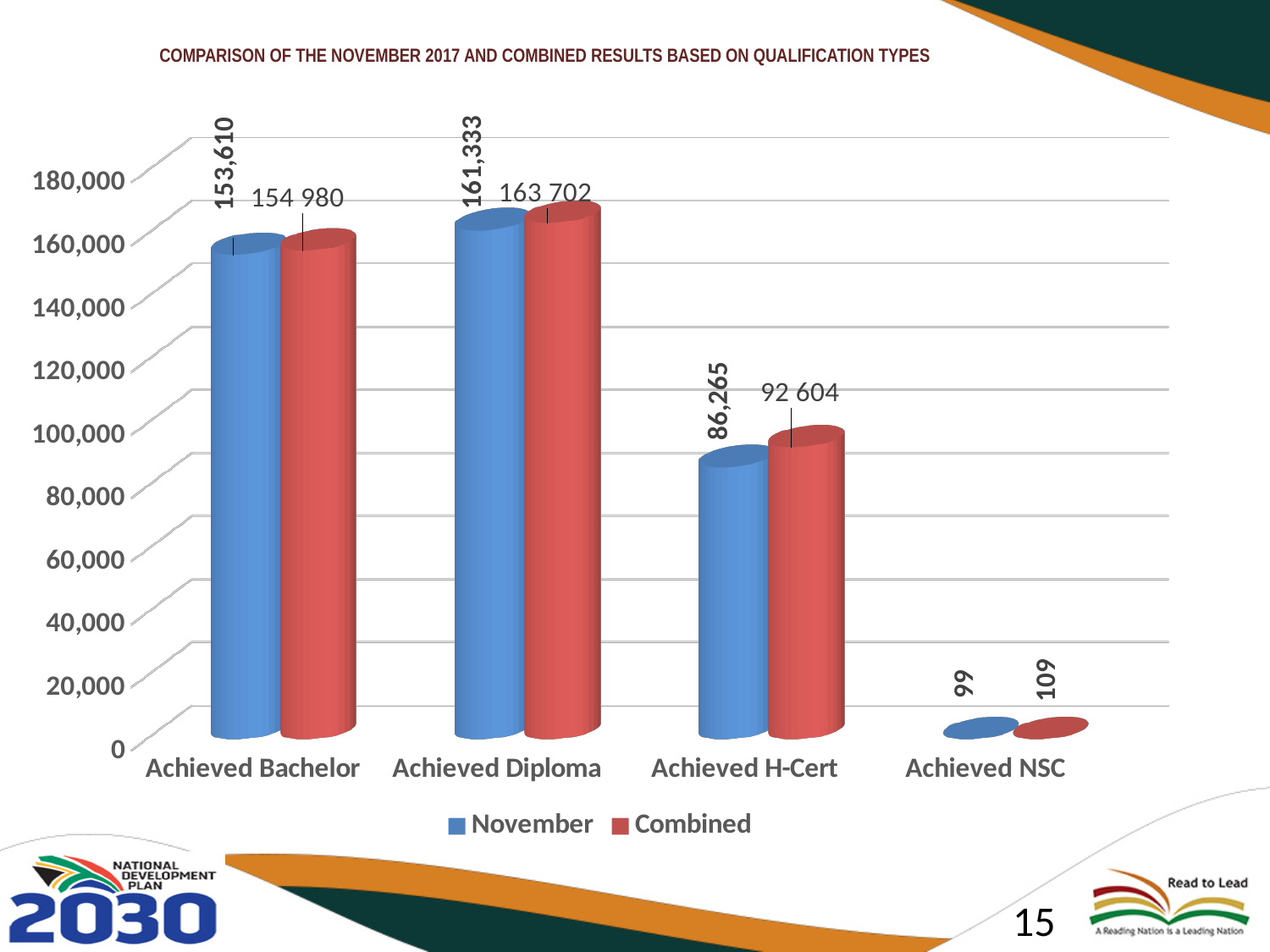
What is the difference between the Combined and November values for Achieved H-Cert? 6,339 What is the November value for Achieved NSC? 99 Which qualification type has the highest Combined value? Achieved Diploma What is the Combined value for Achieved H-Cert? 92 604 Which qualification type has the lowest November value? Achieved NSC What is the November value for Achieved Bachelor? 153,610 What is the difference between the Combined and November values for Achieved NSC? 10 What kind of chart is shown on the slide? Bar chart How many qualification types are shown on the x axis? 4 Which is larger for Achieved Bachelor, the November value or the Combined value? Combined What is the Combined value for Achieved Diploma? 163 702 How many series does the legend list? 2